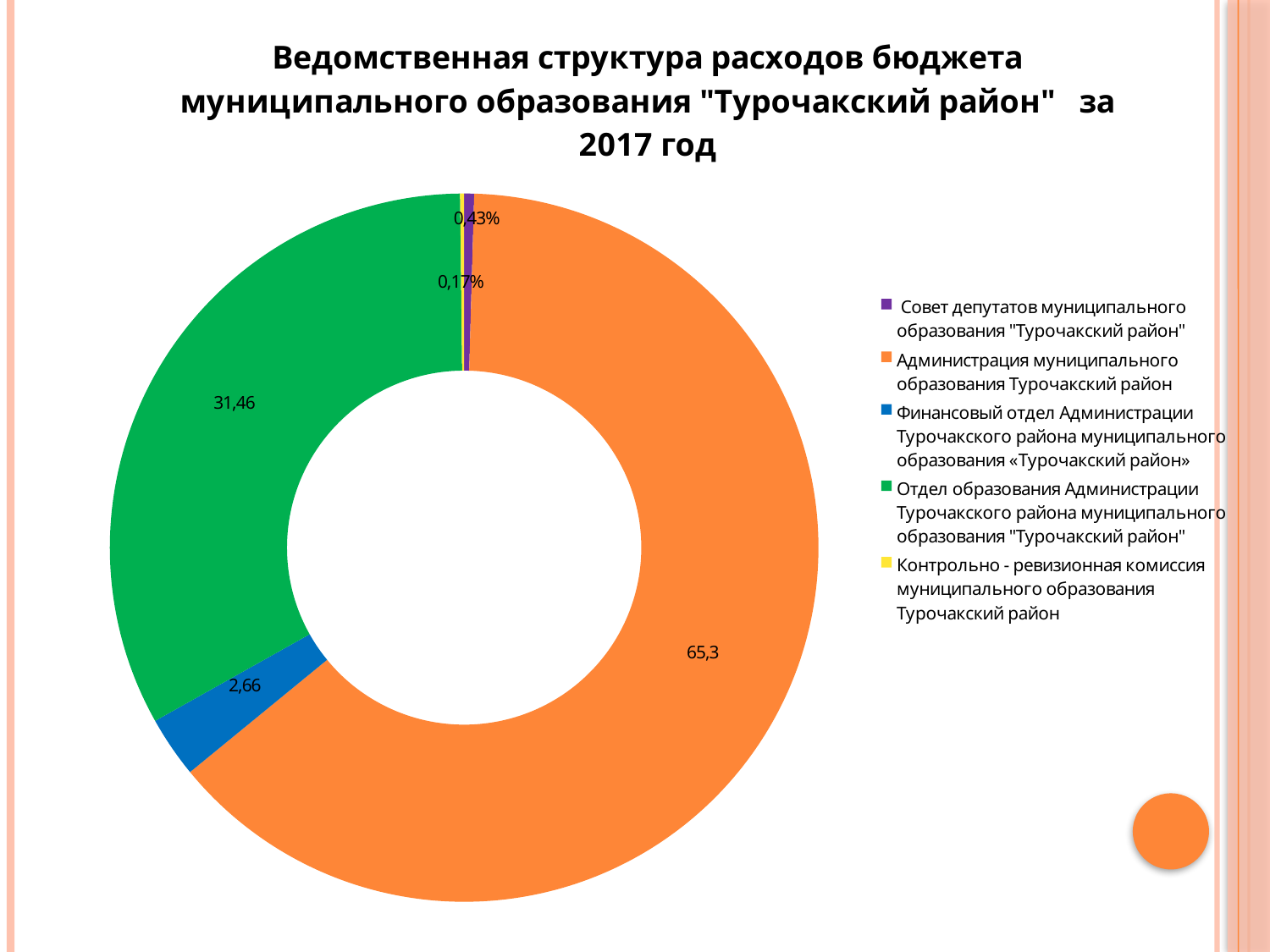
Which is larger: the value for Финансовый отдел Администрации Турочакского района or the value for Совет депутатов муниципального образования "Турочакский район"? Финансовый отдел Администрации Турочакского района What kind of chart is shown on the slide? Doughnut chart Which category has the largest share of the chart? Администрация муниципального образования Турочакский район What is the value for Отдел образования Администрации Турочакского района муниципального образования "Турочакский район"? 31,46 What is the value for Администрация муниципального образования Турочакский район? 65,3 What colour represents Отдел образования Администрации Турочакского района in the chart? Green What is the difference between the values for Администрация муниципального образования Турочакский район and Отдел образования Администрации Турочакского района? 33,84 What is the value for Финансовый отдел Администрации Турочакского района муниципального образования «Турочакский район»? 2,66 How many categories does the chart show? 5 How many entries does the legend list? 5 What is the value for Совет депутатов муниципального образования "Турочакский район"? 0,43% Which category has the smallest share of the chart? Контрольно - ревизионная комиссия муниципального образования Турочакский район